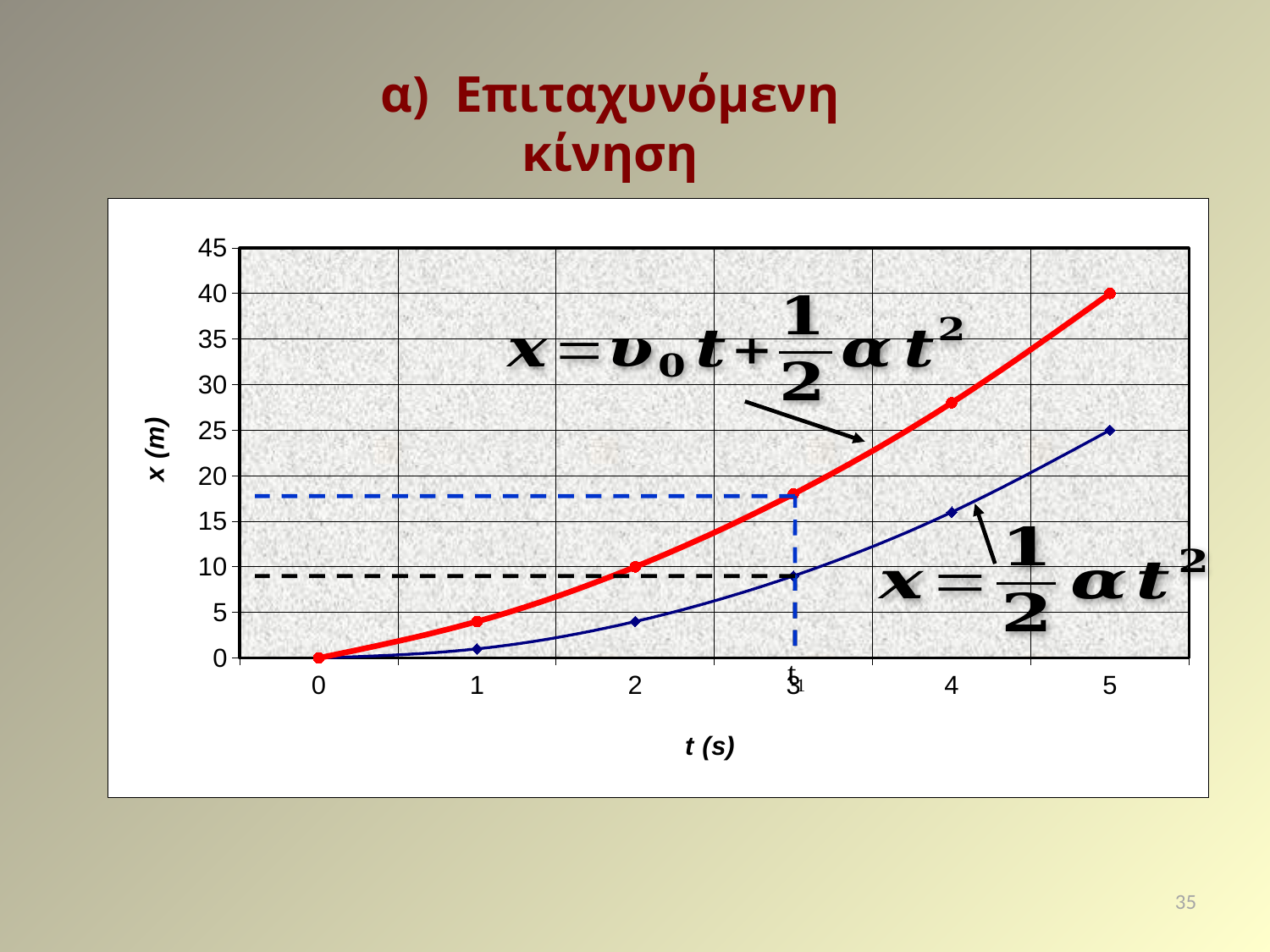
Is the value of the blue curve at t = 4 s greater or less than 20? less How many curves (series) are plotted on the chart? 2 How many data points are marked on the red curve? 6 What is the difference between the red and blue curves at t = 5 s? 15 What is the value of x (m) for the red curve at t = 2 s? 10 What is the value of x (m) for the red curve at t = 5 s? 40 What kind of chart is shown on the slide? line chart At t = 5 s, which curve has the larger x value, the red or the blue? red Is the value of the red curve at t = 4 s greater or less than 25? greater What is the value of x (m) for the blue curve at t = 5 s? 25 Do the values of the curves rise or fall as t increases? rise What is the label of the vertical axis? x (m)